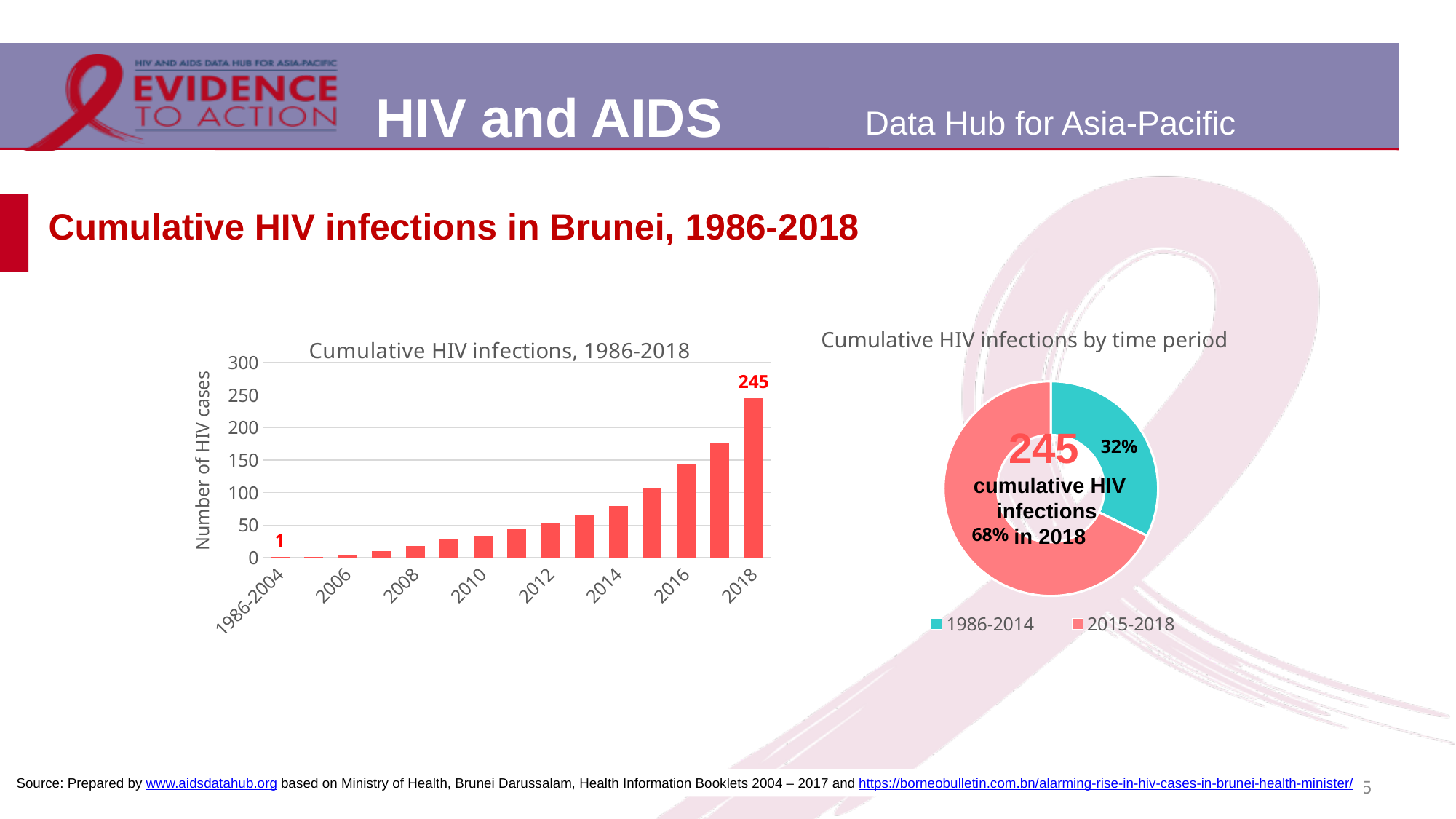
In the bar chart 'Cumulative HIV infections, 1986-2018', what is the difference between the values for 2018 and 1986-2004? 244 In the bar chart 'Cumulative HIV infections, 1986-2018', what is the value for 2018? 245 In the bar chart 'Cumulative HIV infections, 1986-2018', which category has the highest value? 2018 In the donut chart 'Cumulative HIV infections by time period', what share does 2015-2018 have? 68% What kind of chart is 'Cumulative HIV infections, 1986-2018'? bar chart In the donut chart 'Cumulative HIV infections by time period', how many entries does the legend list? 2 In the bar chart 'Cumulative HIV infections, 1986-2018', what is the value for 1986-2004? 1 In the bar chart 'Cumulative HIV infections, 1986-2018', what is the y-axis title? Number of HIV cases In the bar chart 'Cumulative HIV infections, 1986-2018', do the values rise or fall from left to right along the x axis? rise In the bar chart 'Cumulative HIV infections, 1986-2018', is the value for 2014 greater or less than 100? less In the donut chart 'Cumulative HIV infections by time period', what share does 1986-2014 have? 32%